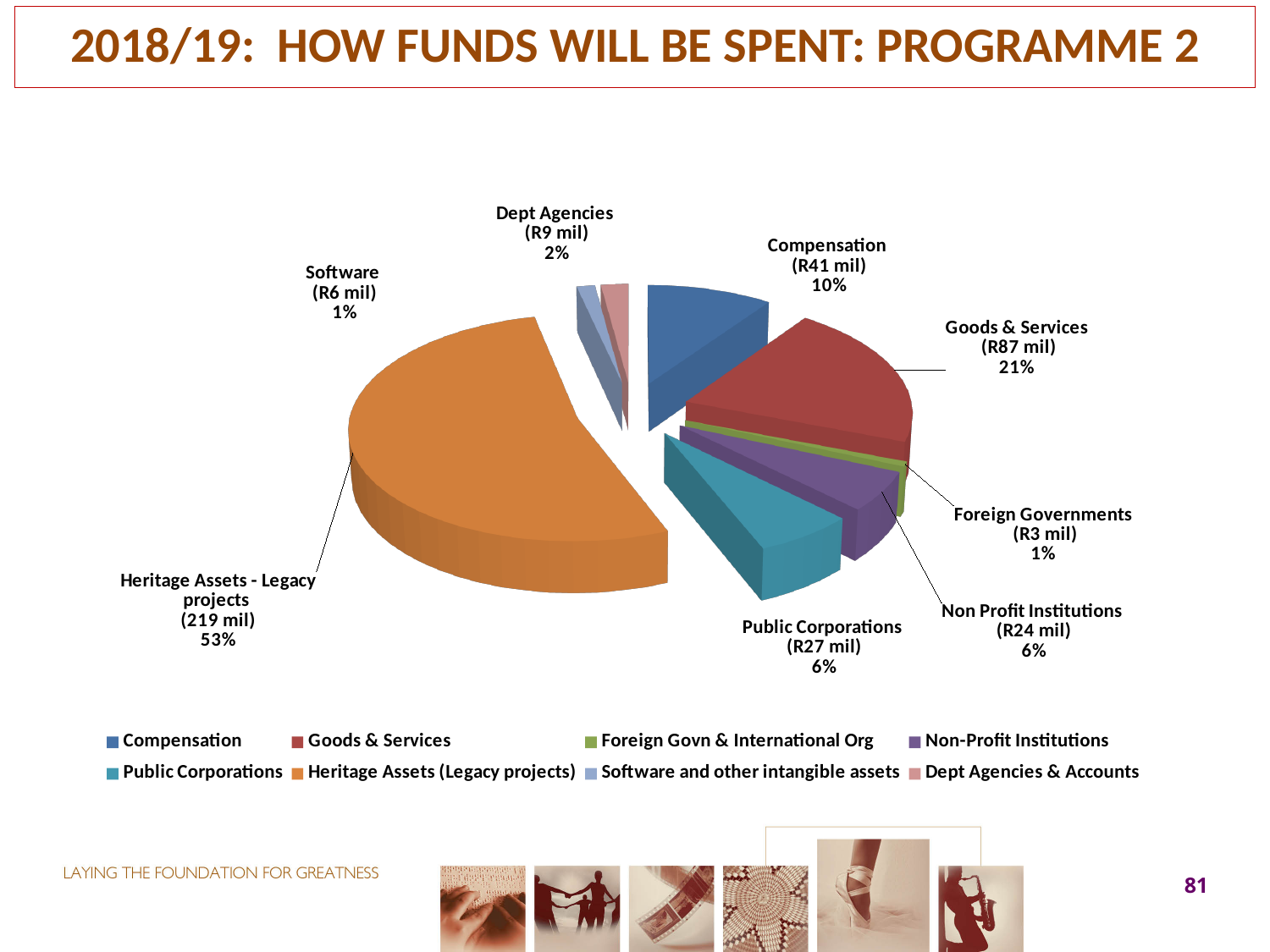
How many slices does the pie chart have? 8 What kind of chart is shown on the slide? Pie chart What is the difference in amount between Goods & Services and Compensation? R46 mil What percentage share does Non Profit Institutions have? 6% What is the amount shown for Foreign Governments? R3 mil What percentage share does Heritage Assets - Legacy projects have? 53% What is the title of the slide containing the chart? 2018/19: HOW FUNDS WILL BE SPENT: PROGRAMME 2 How many entries does the legend list? 8 What is the amount shown for Goods & Services? R87 mil What is the amount shown for Compensation? R41 mil Which is larger, the amount for Public Corporations or the amount for Dept Agencies? Public Corporations Which category has the largest share of the pie? Heritage Assets - Legacy projects